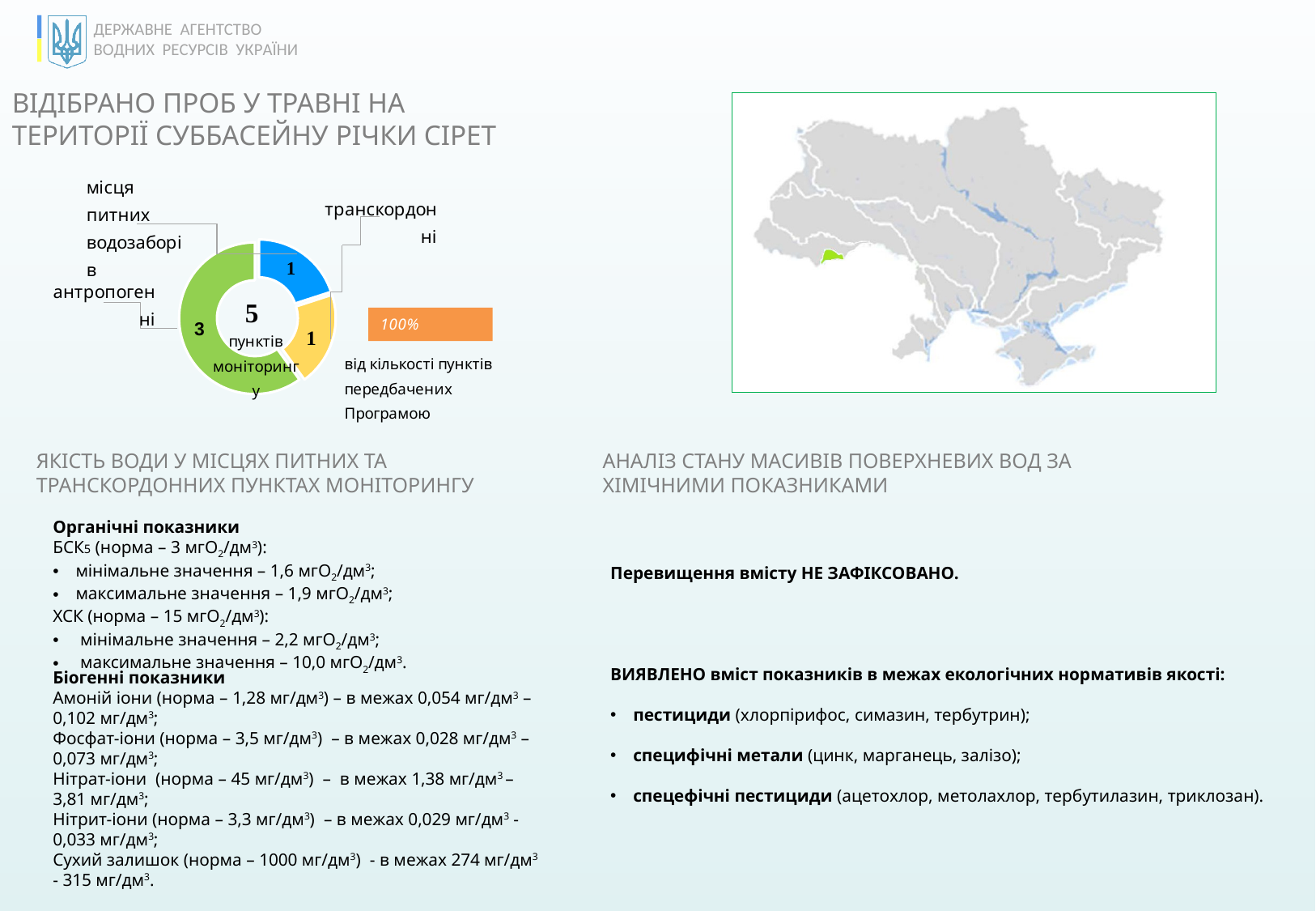
What is the difference between the антропогенні value and the транскордонні value? 2 What is the value shown for the місця питних водозаборів segment? 1 How many segments does the doughnut chart have? 3 What is the value shown for the транскордонні segment? 1 What colour is the largest segment of the doughnut chart? green What text is written in the centre of the doughnut chart? 5 пунктів моніторингу What is the total number of monitoring points shown in the centre of the doughnut chart? 5 Which is larger: the антропогенні segment or the транскордонні segment? антропогенні What share of the total monitoring points does the антропогенні segment represent? 60% What kind of chart is shown on the left of the slide? doughnut (pie) chart Which category has the largest segment in the doughnut chart? антропогенні What is the value shown for the антропогенні segment? 3